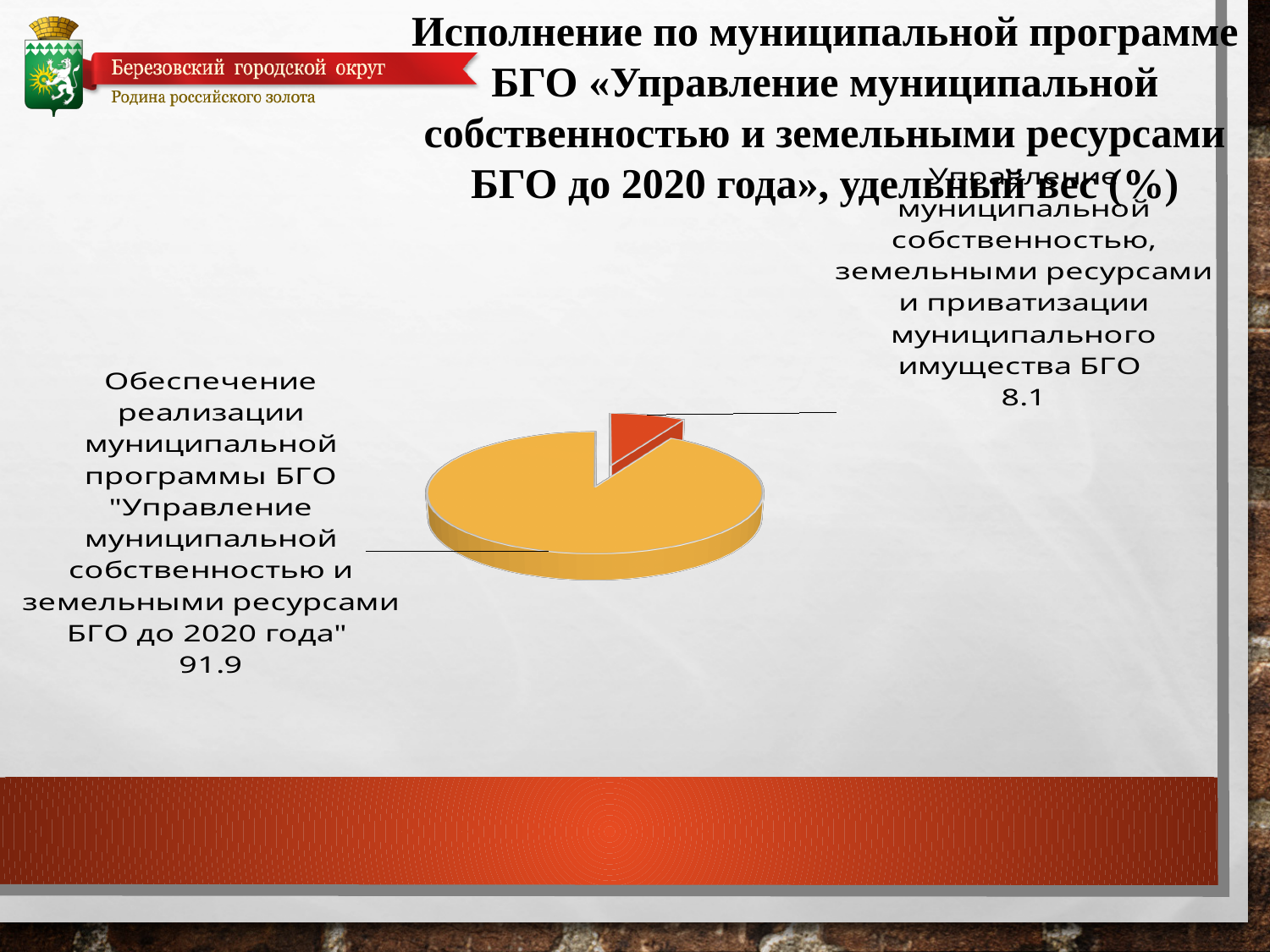
What is the value for the slice labelled "Обеспечение реализации муниципальной программы БГО "Управление муниципальной собственностью и земельными ресурсами БГО до 2020 года""? 91.9 What is the difference between the two slice values shown on the pie chart? 83.8 What is the total of the two slice values shown on the pie chart? 100 Which slice of the pie chart has the smallest value? Управление муниципальной собственностью, земельными ресурсами и приватизации муниципального имущества БГО What unit is indicated in the chart title for the values shown? % What is the value for the slice labelled "Управление муниципальной собственностью, земельными ресурсами и приватизации муниципального имущества БГО"? 8.1 What share of the pie does the small red-orange slice represent? 8.1 What colour is the largest slice of the pie chart? Yellow-orange How many slices does the pie chart have? 2 Which is larger: the value for "Обеспечение реализации муниципальной программы..." or the value for "Управление муниципальной собственностью, земельными ресурсами и приватизации..."? Обеспечение реализации муниципальной программы БГО "Управление муниципальной собственностью и земельными ресурсами БГО до 2020 года" Which slice of the pie chart has the largest value? Обеспечение реализации муниципальной программы БГО "Управление муниципальной собственностью и земельными ресурсами БГО до 2020 года" What kind of chart is shown on the slide? Pie chart